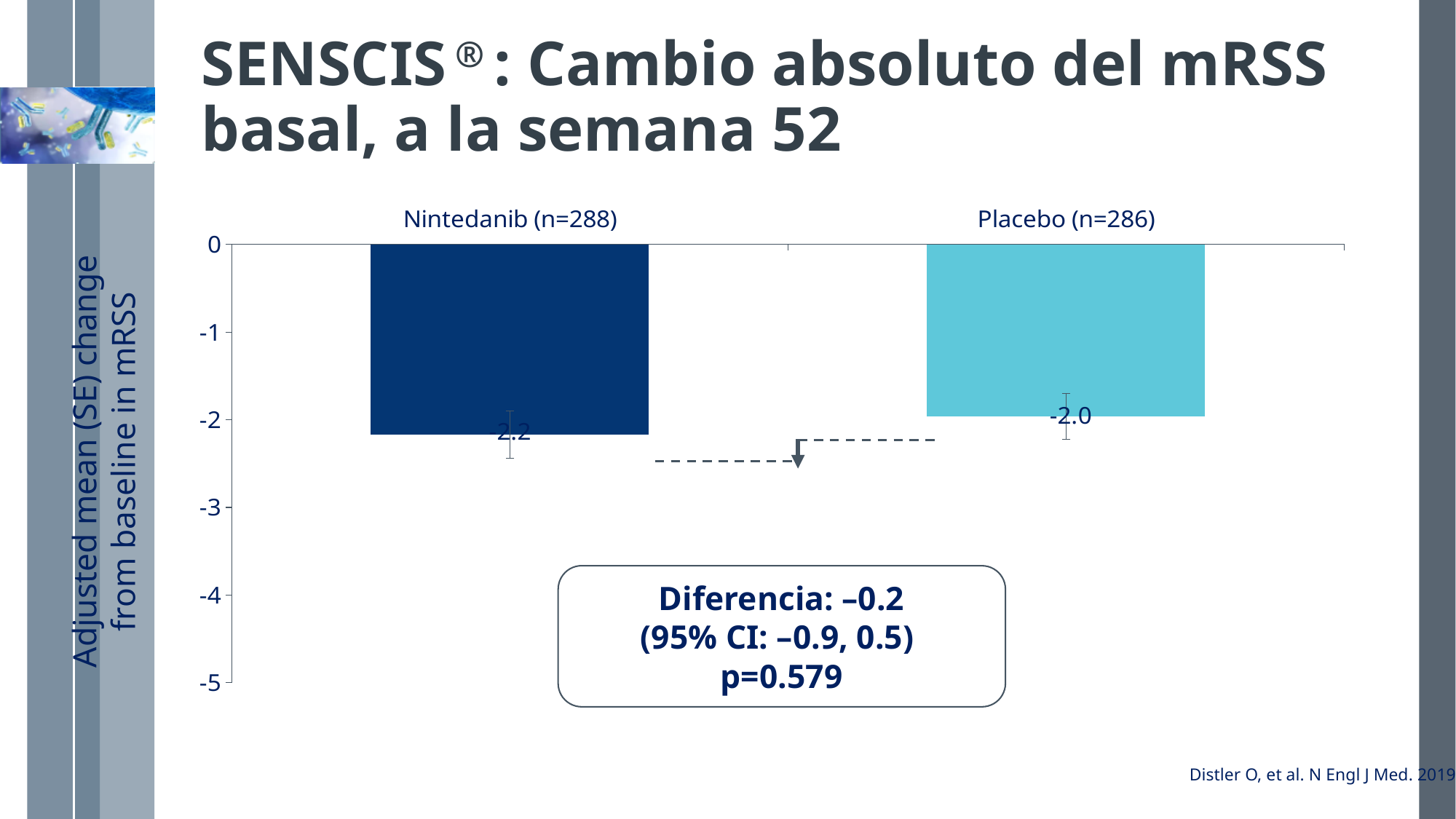
What is the label of the vertical axis of the chart? Adjusted mean (SE) change from baseline in mRSS How many bars are shown in the chart? 2 What is the difference between the Nintedanib value (-2.2) and the Placebo value (-2.0)? -0.2 What is the adjusted mean change from baseline in mRSS for Placebo (n=286)? -2.0 Which group shows the larger decrease (more negative change) in mRSS, Nintedanib or Placebo? Nintedanib What is the adjusted mean change from baseline in mRSS for Nintedanib (n=288)? -2.2 What p-value is reported in the box on the chart for the difference between groups? p=0.579 Is the value for Nintedanib (n=288) greater or less than -2? less What type of chart is shown on the slide? Bar chart Which group has the highest (least negative) value on the chart? Placebo (n=286) Which group has the lowest (most negative) value on the chart? Nintedanib (n=288)